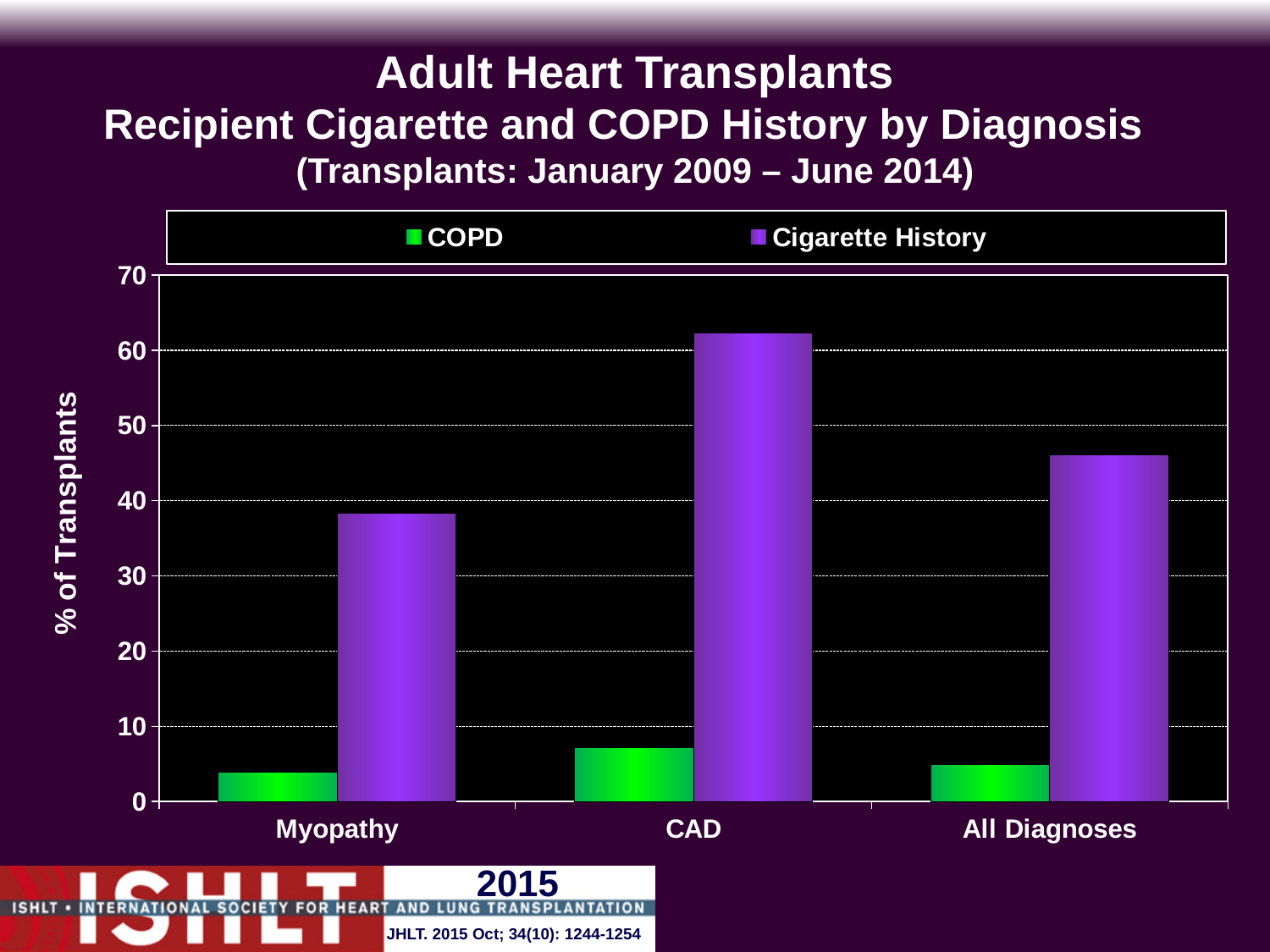
What is the label of the y axis? % of Transplants How many diagnosis categories are shown on the x axis? 3 Is the COPD value for CAD greater or less than 10? less Which diagnosis category has the highest COPD value? CAD How many series does the legend list? 2 Is the Cigarette History value for CAD greater or less than 50? greater For CAD, which is larger: the COPD value or the Cigarette History value? Cigarette History Which diagnosis category has the highest Cigarette History value? CAD Is the Cigarette History value for Myopathy greater or less than 30? greater What type of chart is shown on the slide? bar chart Which diagnosis category has the lowest Cigarette History value? Myopathy